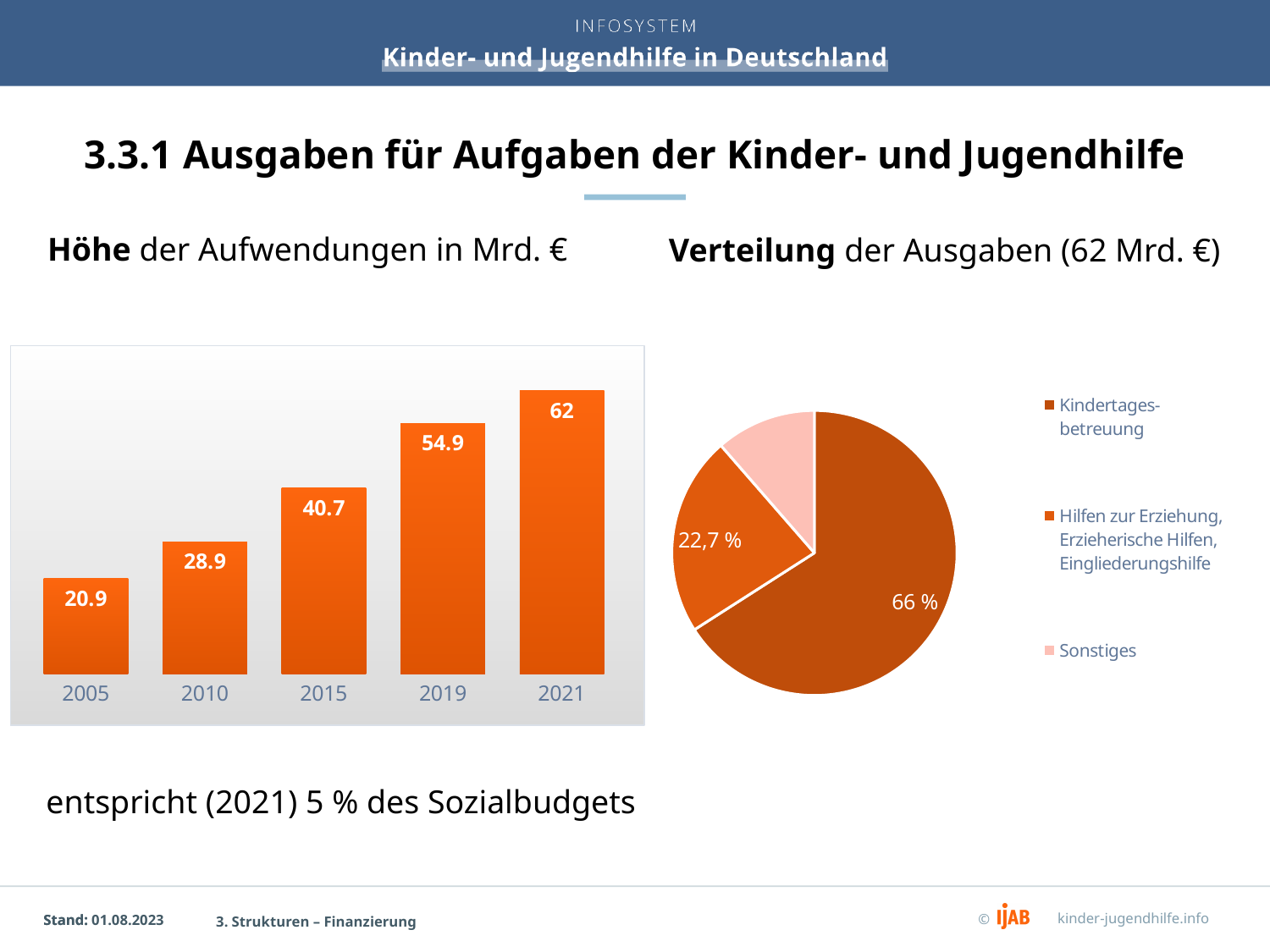
How many bars are shown in the bar chart on the left? 5 In the bar chart on the left, what is the value for 2005? 20.9 In the bar chart on the left, which year has the highest value? 2021 In the bar chart on the left, which is larger, the value for 2010 or the value for 2015? 2015 How many entries does the legend of the pie chart on the right list? 3 In the bar chart on the left, which year has the lowest value? 2005 In the bar chart on the left, what is the difference between the values for 2019 and 2010? 26 In the bar chart on the left (Höhe der Aufwendungen in Mrd. €), what is the value for 2015? 40.7 What kind of chart is the chart on the left of the slide? bar chart Do the values in the bar chart on the left rise or fall from 2005 to 2021? rise In the pie chart on the right (Verteilung der Ausgaben), what share is shown for Kindertagesbetreuung? 66 % In the bar chart on the left, what is the value for 2021? 62